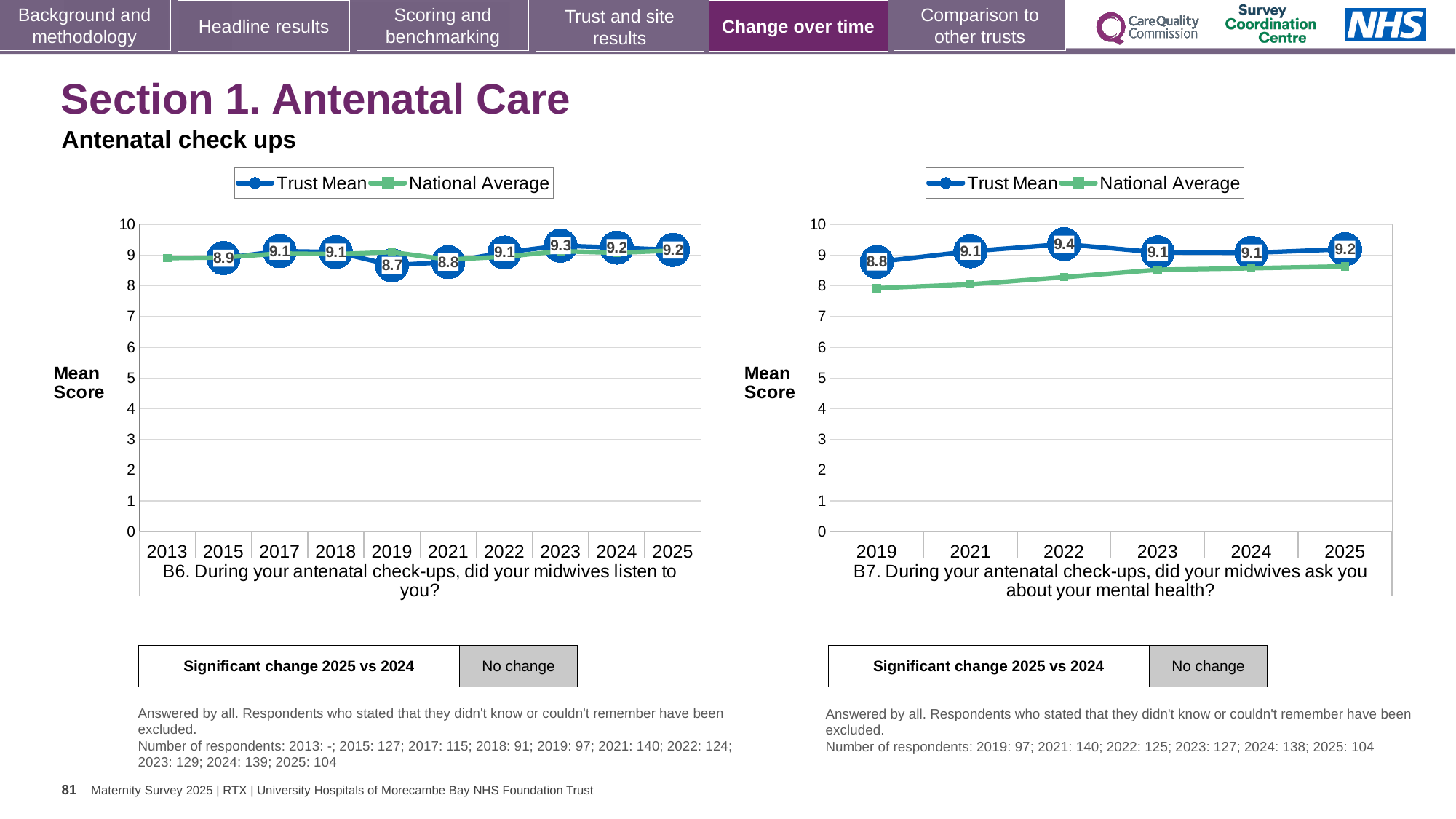
In the B6 chart (left), what is the Trust Mean for 2019? 8.7 How many series does the legend of the B6 chart (left) list? 2 In the B7 chart (right), does the National Average rise or fall from 2019 to 2025? Rise In the B6 chart (left), which year has the lowest labelled Trust Mean? 2019 How many years are shown on the x axis of the B7 chart (right)? 6 In the B6 chart (left), is the Trust Mean higher in 2023 or in 2021? 2023 In the B6 chart (left), what is the Trust Mean for 2023? 9.3 In the B7 chart (right), what is the difference between the Trust Mean in 2022 and in 2019? 0.6 In the B7 chart (right), which year has the highest Trust Mean? 2022 In the B7 chart (right), what is the Trust Mean for 2022? 9.4 In the B7 chart (right), is the National Average for 2019 greater or less than 8? less What type of chart is the B7 chart (right)? Line chart